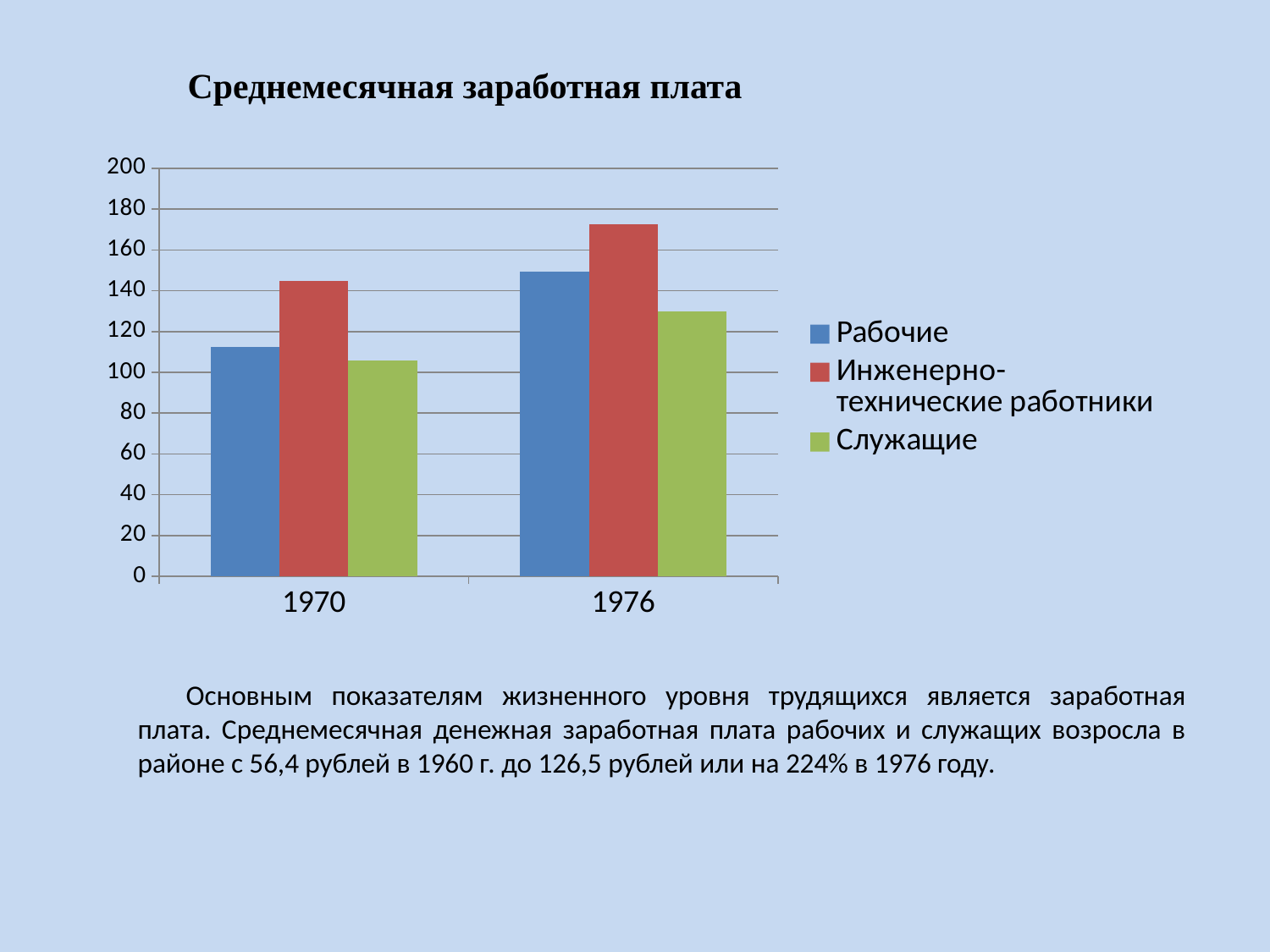
Do the values for Служащие rise or fall from 1970 to 1976? rise Which series has the lowest value in 1970? Служащие Which colour represents Служащие in the legend? green Is the value for Рабочие in 1970 greater or less than 100? greater How many year categories are shown on the x axis? 2 What kind of chart is shown on the slide? bar chart Is the value for Служащие in 1976 greater or less than 120? greater Is the value for Инженерно-технические работники in 1976 greater or less than 180? less Which is larger: the value for Рабочие in 1976 or the value for Инженерно-технические работники in 1970? Рабочие in 1976 How many series does the legend list? 3 Which series has the highest value in 1976? Инженерно-технические работники What is the title of the chart? Среднемесячная заработная плата